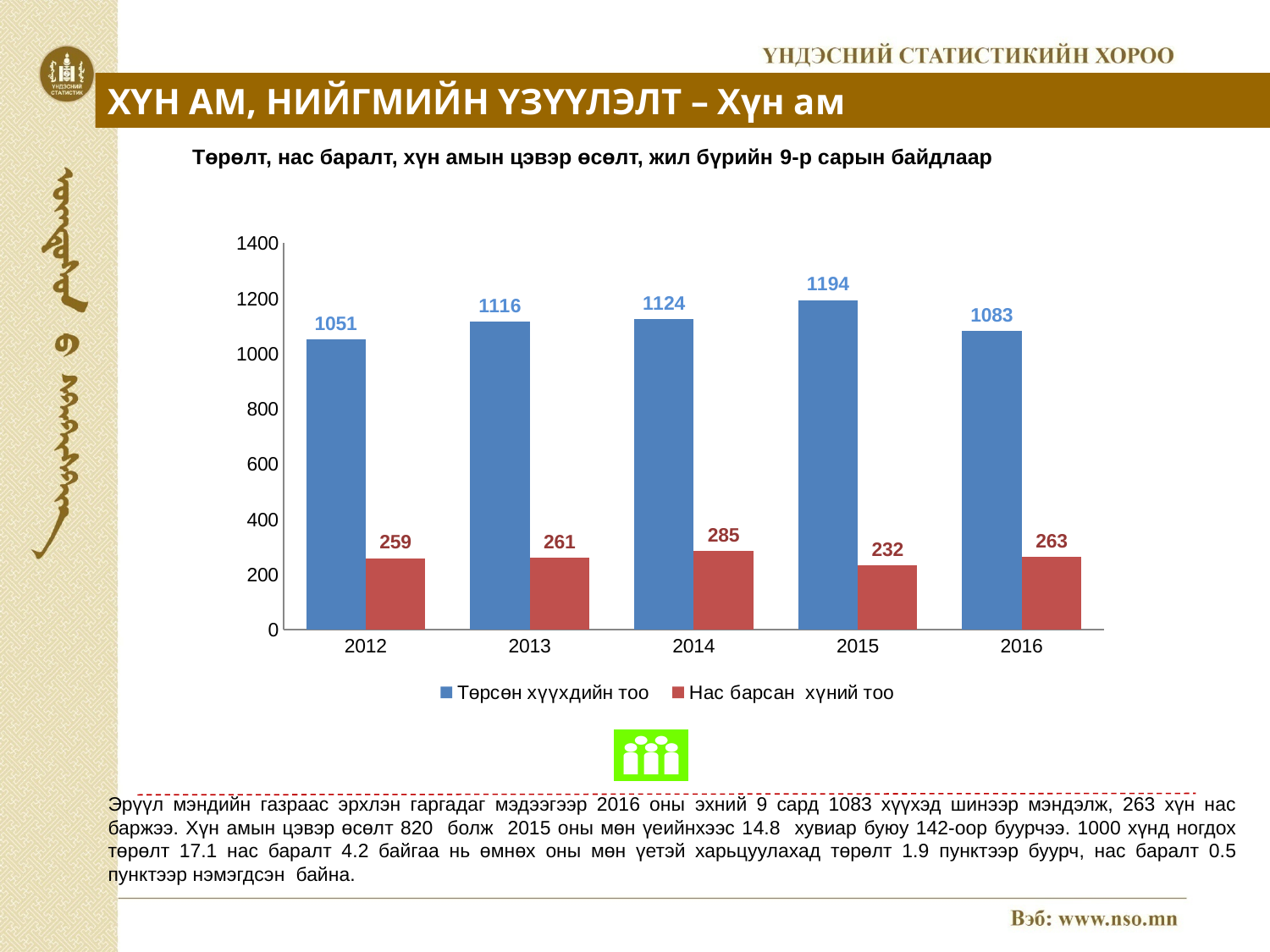
How many series does the legend list? 2 Is the value of Төрсөн хүүхдийн тоо for 2012 greater or less than 1000? greater In which year is Төрсөн хүүхдийн тоо the highest? 2015 What is the value of Төрсөн хүүхдийн тоо for 2015? 1194 Does Төрсөн хүүхдийн тоо rise or fall from 2012 to 2015? Rise How many years are shown on the x axis of the chart? 5 Which is larger: Нас барсан хүний тоо in 2012 or in 2016? 2016 What type of chart is shown on the slide? Bar chart What is the difference between Төрсөн хүүхдийн тоо and Нас барсан хүний тоо in 2016? 820 In which year is Нас барсан хүний тоо the lowest? 2015 What colour are the bars for Нас барсан хүний тоо? Red What is the value of Нас барсан хүний тоо for 2014? 285